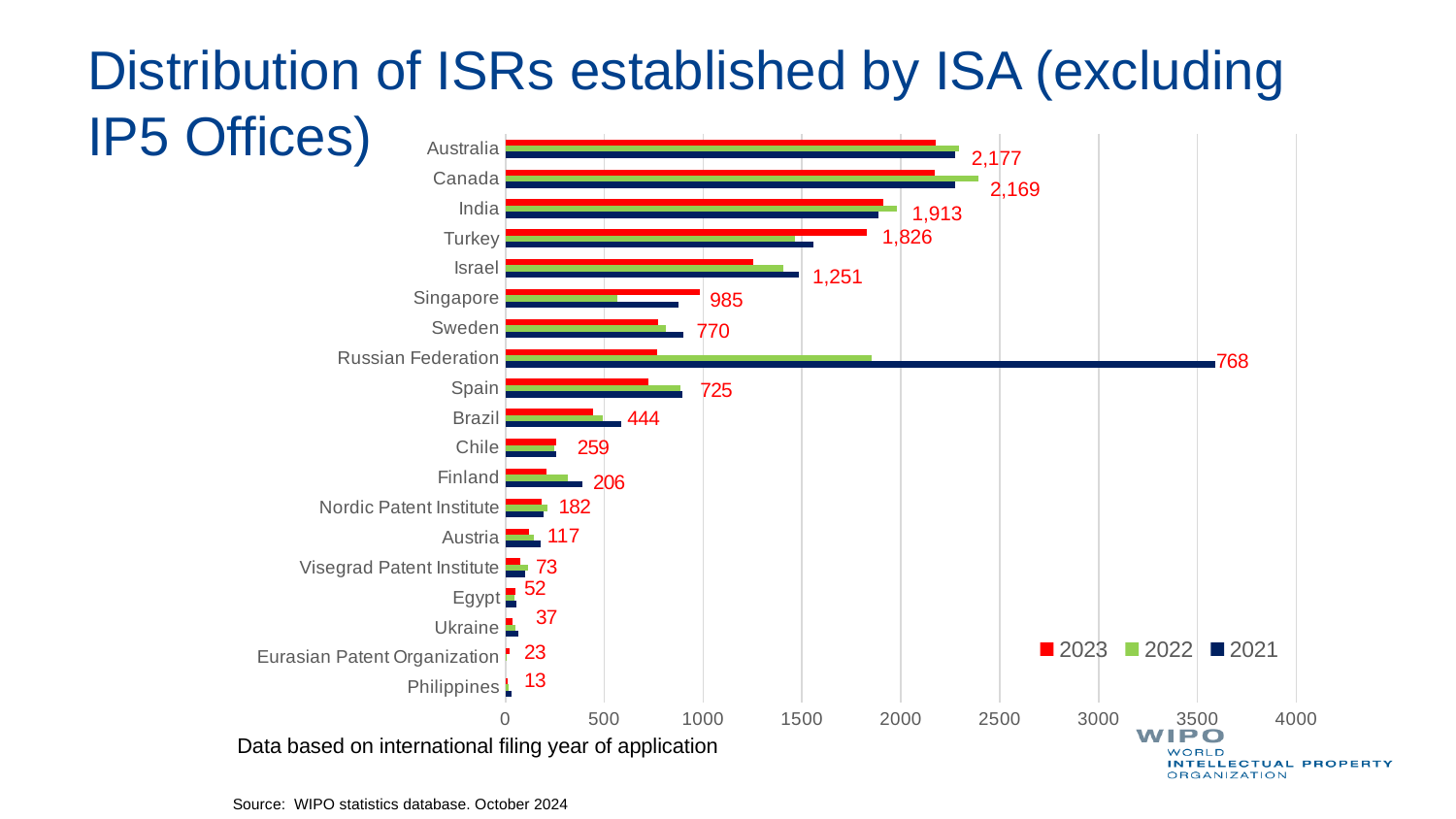
Which ISA has the highest 2023 value? Australia What is the 2023 value for Australia? 2,177 Which ISA has the lowest 2023 value? Philippines What kind of chart is shown on the slide? Bar chart Is the 2022 value for Canada greater or less than 2000? greater Is the 2021 value for the Russian Federation greater or less than 3500? greater How many ISAs are listed on the chart? 19 Which has the larger 2023 value, Turkey or Israel? Turkey What is the 2023 value for Singapore? 985 What is the 2023 value for the Nordic Patent Institute? 182 What is the difference between the 2023 values for Australia and Canada? 8 How many series does the legend list? 3